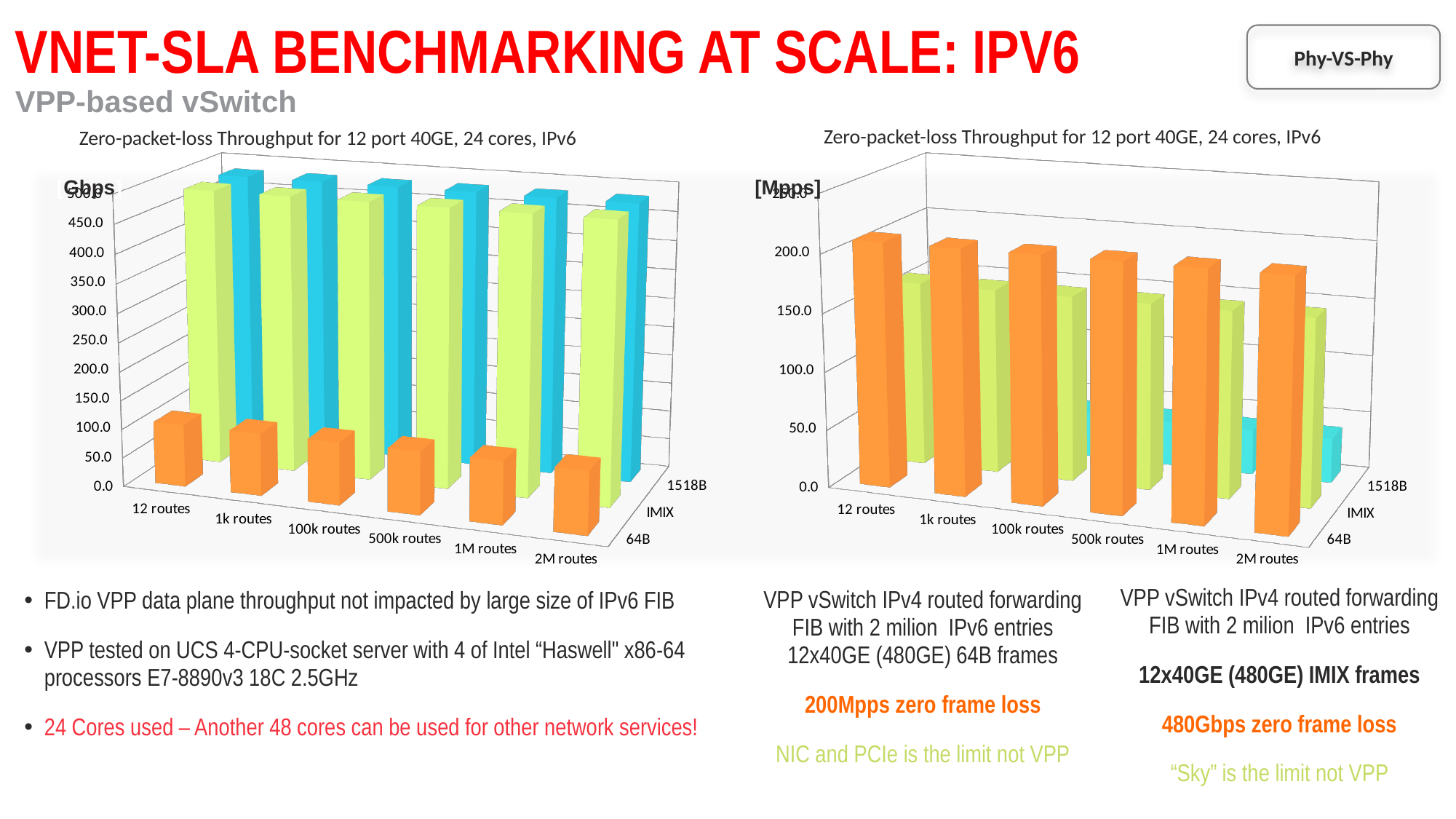
How many route-count categories are shown on the x axis of the right chart (Mpps)? 6 In the left chart (Gbps), is the value for 1518B at 12 routes greater or less than 400.0? greater What unit label is shown on the vertical axis of the right chart? [Mpps] What kind of chart is the left chart (Gbps)? bar chart How many series does the left chart (Gbps) show? 3 In the left chart (Gbps), which series has the lowest value at 2M routes? 64B In the right chart (Mpps), which series has the lowest value at 2M routes? 1518B In the left chart (Gbps), is the value for 64B at 12 routes greater or less than 200.0? less In the right chart (Mpps), is the value for 1518B at 2M routes greater or less than 100.0? less In the right chart (Mpps), which series has the highest value at 12 routes? 64B In the right chart (Mpps), which is larger at 1k routes: 64B or IMIX? 64B